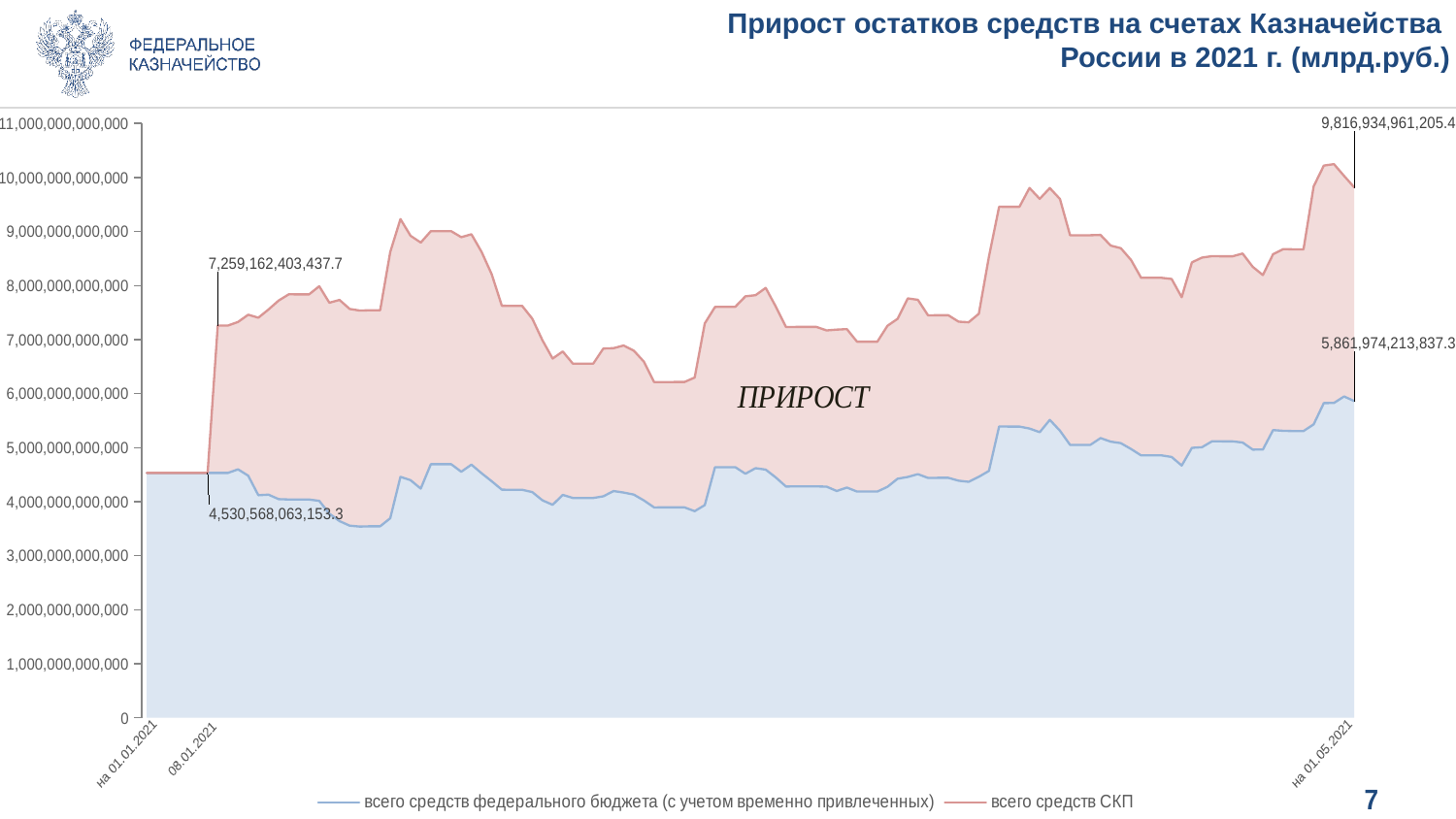
What is the value of всего средств СКП on 08.01.2021? 7,259,162,403,437.7 What is the value of всего средств СКП on 01.05.2021? 9,816,934,961,205.4 By how much did всего средств федерального бюджета (с учетом временно привлеченных) increase from 08.01.2021 to 01.05.2021? 1,331,406,150,684.0 How many series does the legend list? 2 What is the value of всего средств федерального бюджета (с учетом временно привлеченных) on 01.05.2021? 5,861,974,213,837.3 Which series has the higher value on 01.05.2021? всего средств СКП What kind of chart is shown on the slide? area chart What is the title of the chart? Прирост остатков средств на счетах Казначейства России в 2021 г. (млрд.руб.) What is the difference between всего средств СКП and всего средств федерального бюджета on 01.05.2021? 3,954,960,747,368.1 By how much did всего средств СКП increase from 08.01.2021 to 01.05.2021? 2,557,772,557,767.7 Is the value for всего средств СКП on 01.01.2021 greater or less than 5,000,000,000,000? less What is the value of всего средств федерального бюджета (с учетом временно привлеченных) on 08.01.2021? 4,530,568,063,153.3